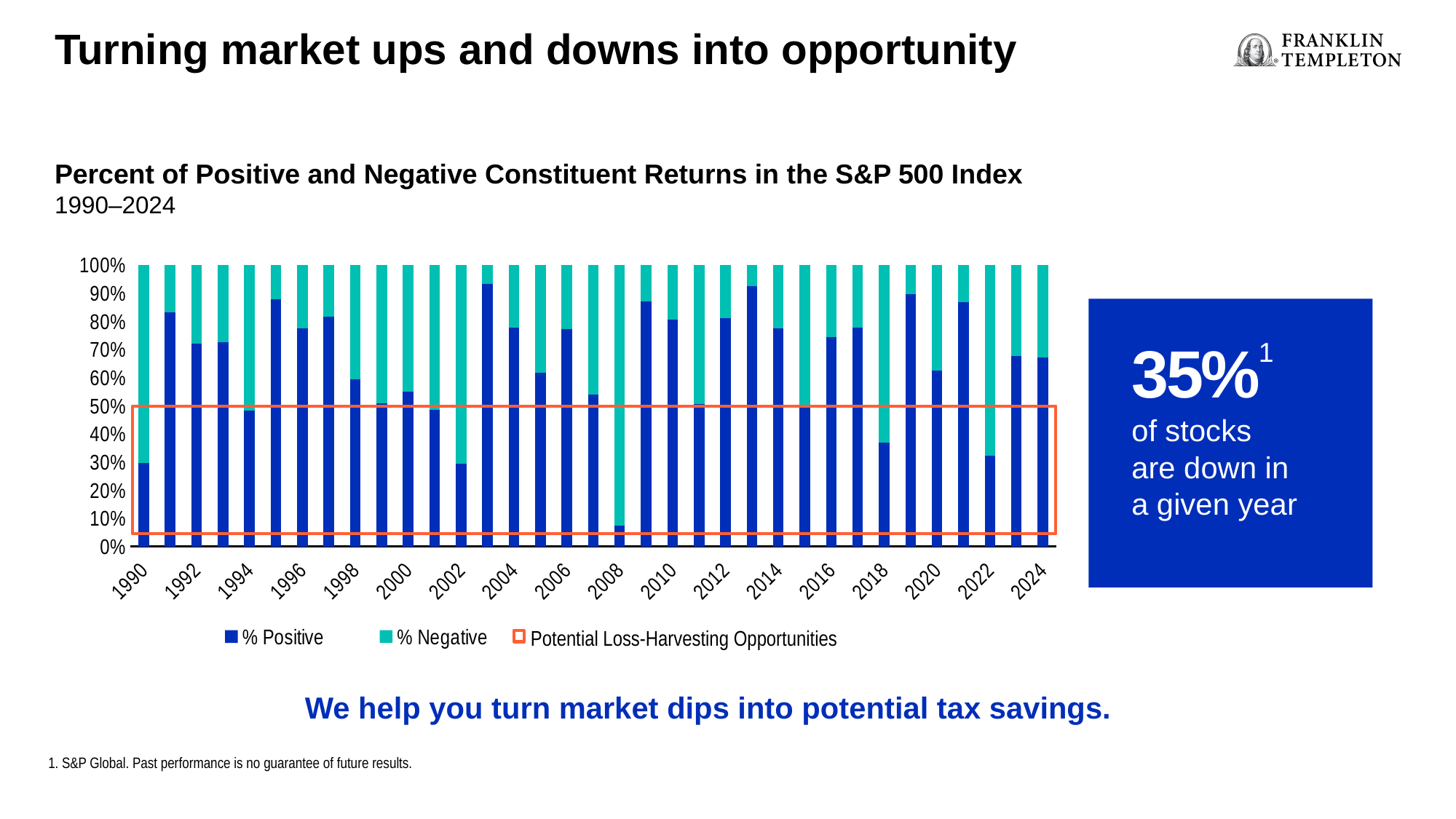
What kind of chart is shown on the slide? Stacked bar chart Which year has the larger % Positive value, 1990 or 1991? 1991 What does the orange outlined box in the chart represent, according to the legend? Potential Loss-Harvesting Opportunities Is the % Positive value for 2022 greater or less than 40%? less Is the % Positive value for 2008 greater or less than 10%? less Is the % Positive value for 2003 greater or less than 90%? greater How many series does the chart legend list? 3 Which year has the larger % Positive value, 2008 or 2009? 2009 How many years (bars) are plotted in the chart? 35 Which year has the lowest % Positive value? 2008 What do the % Positive and % Negative segments of each bar add up to? 100%